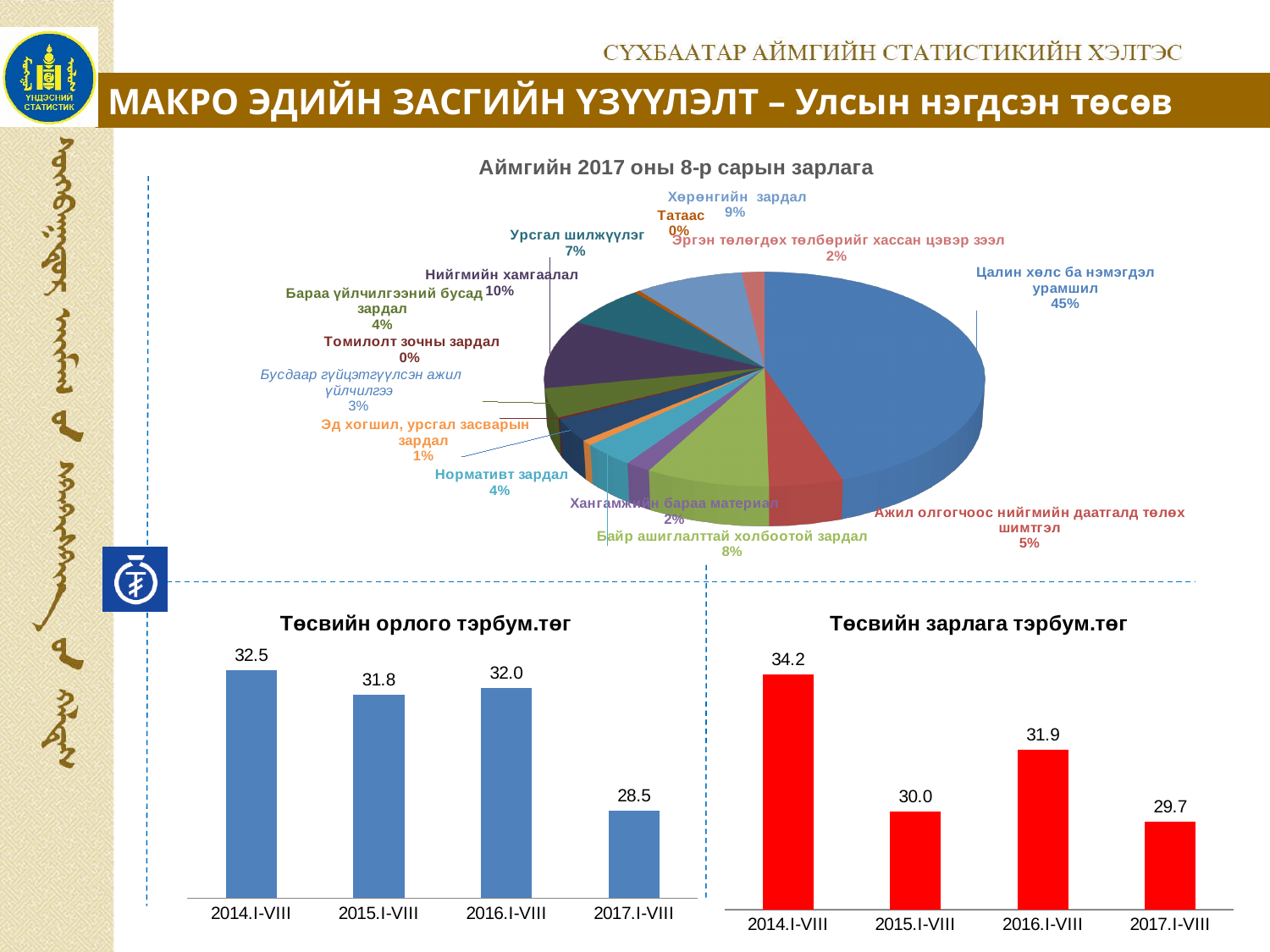
In the pie chart 'Аймгийн 2017 оны 8-р сарын зарлага', what share does 'Нийгмийн хамгаалал' have? 10% In the chart 'Төсвийн орлого тэрбум.төг', what is the difference between 2014.I-VIII and 2017.I-VIII? 4.0 In the chart 'Төсвийн зарлага тэрбум.төг', what is the difference between 2014.I-VIII and 2015.I-VIII? 4.2 In the chart 'Төсвийн орлого тэрбум.төг', which period has the lowest value? 2017.I-VIII In the pie chart 'Аймгийн 2017 оны 8-р сарын зарлага', what share does 'Цалин хөлс ба нэмэгдэл урамшил' have? 45% In the chart 'Төсвийн орлого тэрбум.төг', what is the value for 2015.I-VIII? 31.8 In the pie chart 'Аймгийн 2017 оны 8-р сарын зарлага', which category has the largest share? Цалин хөлс ба нэмэгдэл урамшил In the chart 'Төсвийн зарлага тэрбум.төг', which period has the highest value? 2014.I-VIII In the pie chart 'Аймгийн 2017 оны 8-р сарын зарлага', which is larger: 'Хөрөнгийн зардал' or 'Урсгал шилжүүлэг'? Хөрөнгийн зардал How many periods are shown on the x axis of the chart 'Төсвийн орлого тэрбум.төг'? 4 In the chart 'Төсвийн зарлага тэрбум.төг', what is the value for 2016.I-VIII? 31.9 What type of chart is 'Төсвийн зарлага тэрбум.төг'? Bar chart